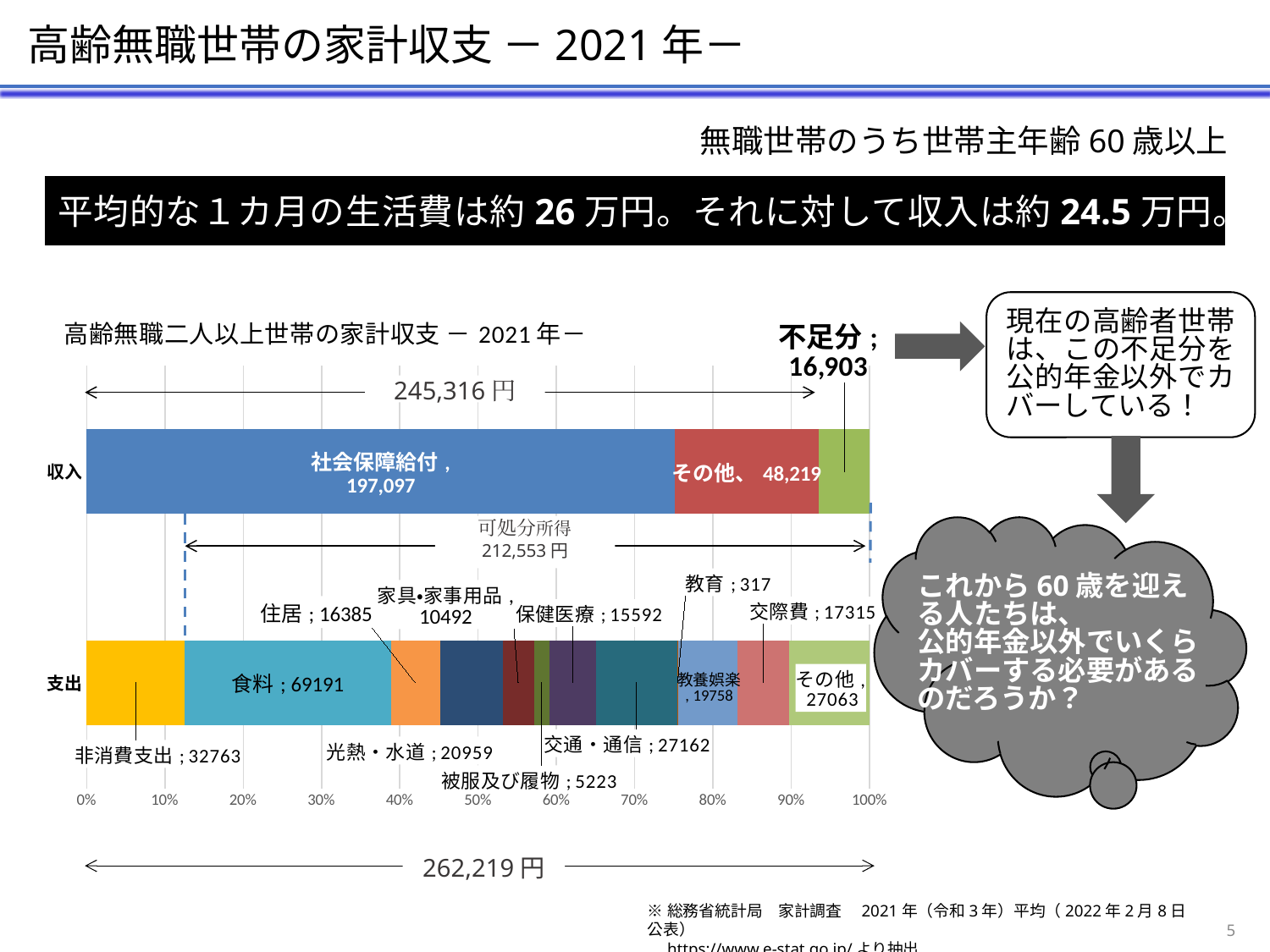
What is the value of 社会保障給付 in the 収入 bar? 197,097 Which segment of the 支出 bar has the largest value? 食料 What is the difference between 交通・通信 and 光熱・水道 in the 支出 bar? 6203 Which is larger in the 支出 bar, 交際費 or 住居? 交際費 What kind of chart is shown on the slide? Stacked bar chart Which segment of the 支出 bar has the smallest value? 教育 What is the total of the 収入 bar (社会保障給付, その他 and 不足分 combined)? 262,219 How many segments make up the 支出 bar? 12 What is the value of 不足分 shown on the chart? 16,903 What is the value of 食料 in the 支出 bar? 69191 What is the value of 教育 in the 支出 bar? 317 What is the value of その他 in the 収入 bar? 48,219